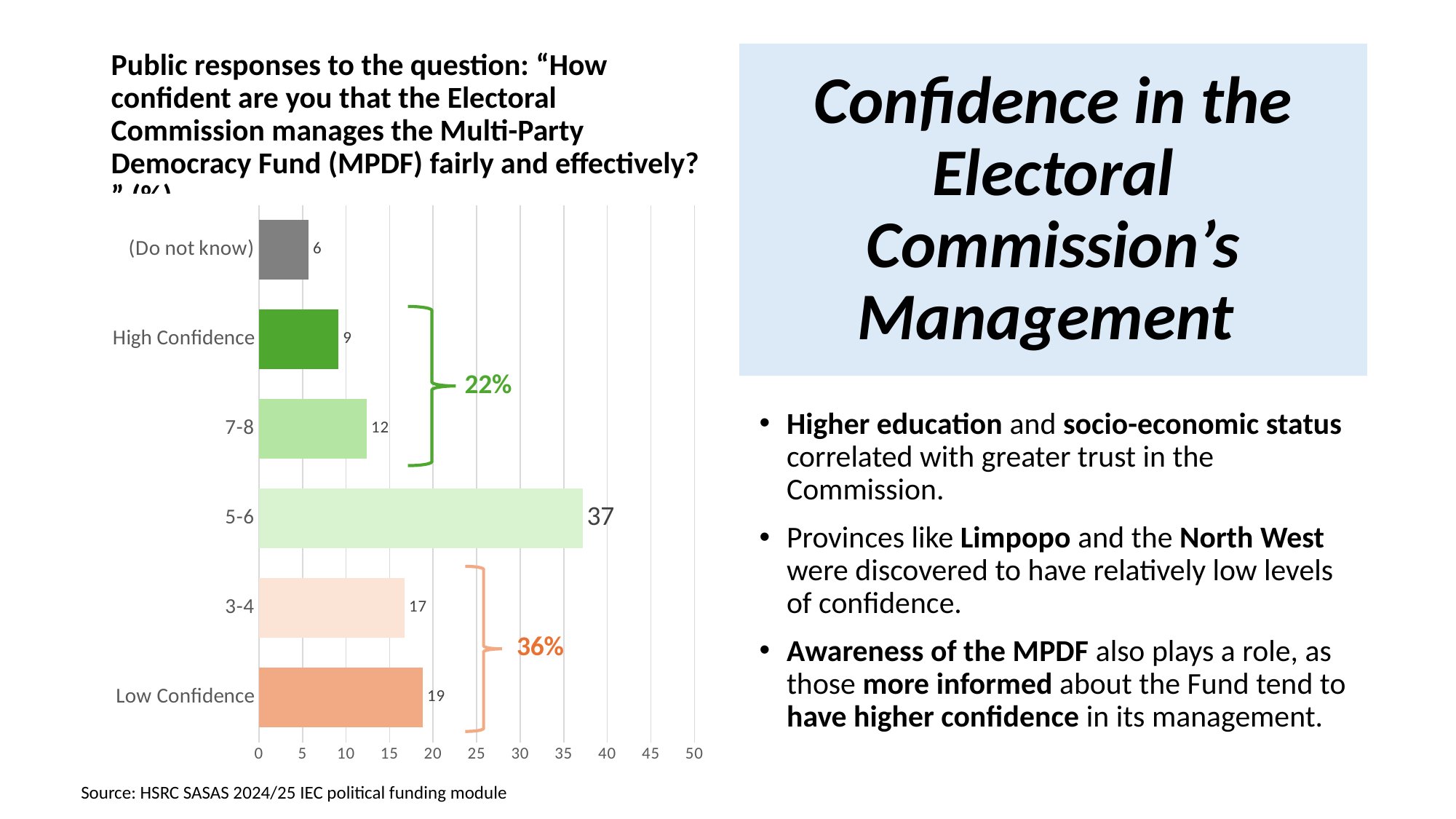
What is the difference between the values for Low Confidence and High Confidence? 10 What is the value for the 5-6 category? 37 What is the value for the (Do not know) category? 6 What kind of chart is shown on the slide? Bar chart Which category has the lowest value? (Do not know) Which is larger, the value for 3-4 or the value for 7-8? 3-4 What is the value for Low Confidence? 19 What is the value for High Confidence? 9 Is the value for 5-6 greater or less than 35? greater How many categories are shown in the chart? 6 Which category has the highest value? 5-6 What percentage is shown by the orange bracket grouping the 3-4 and Low Confidence bars? 36%